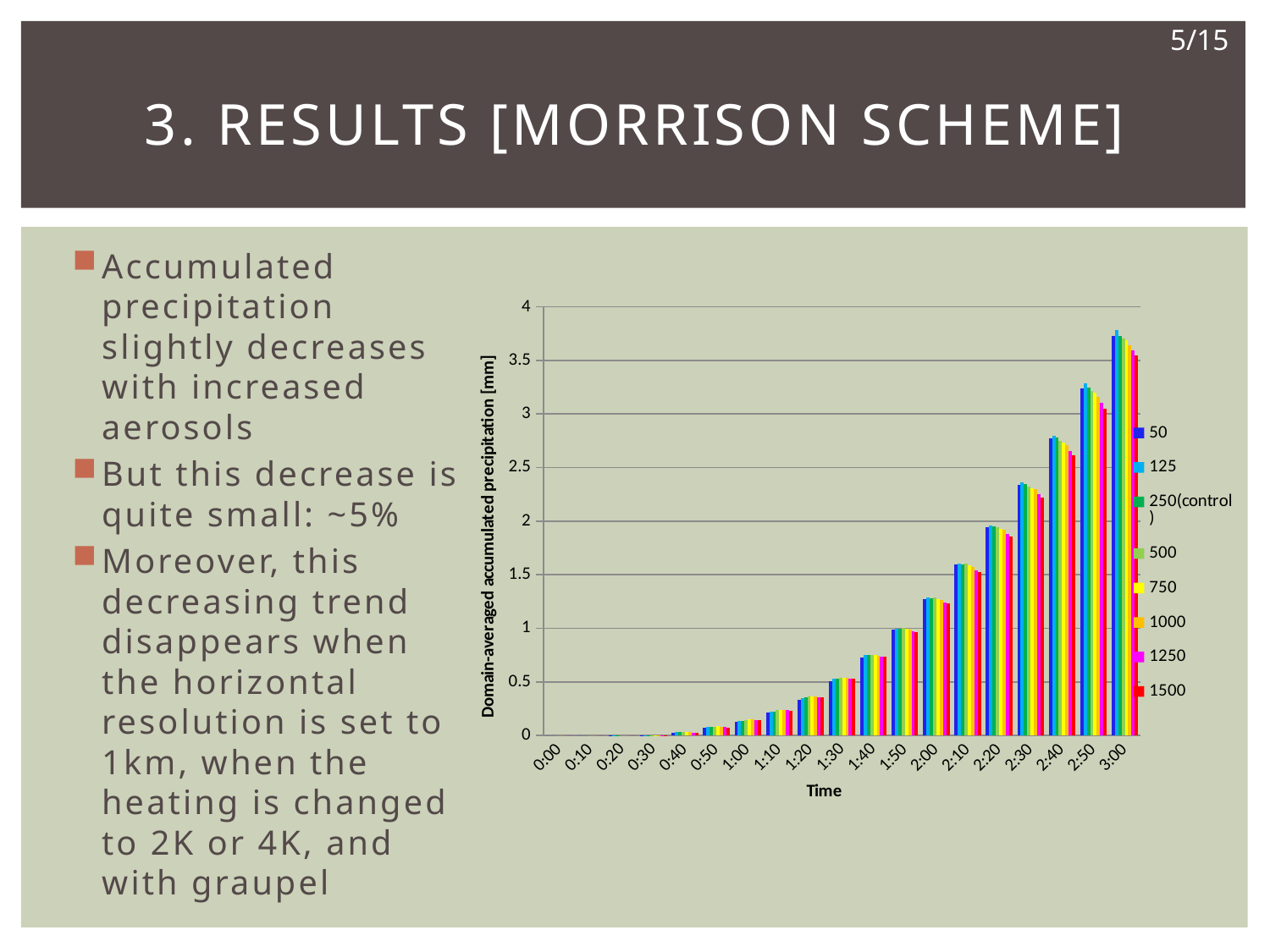
Is the value for the 50 series at 1:00 greater or less than 0.5? less How many series does the legend list? 8 Is the value for the 1500 series at 2:30 greater or less than 2? greater Is the value for the 50 series at 3:00 greater or less than 3.5? greater Do the accumulated precipitation values rise or fall as time increases along the x axis? rise At which time are the accumulated precipitation values highest? 3:00 Which legend entry is marked as the control? 250(control) How many time points are shown along the x axis? 19 What kind of chart is shown on the slide? bar chart What is the label of the y axis? Domain-averaged accumulated precipitation [mm]